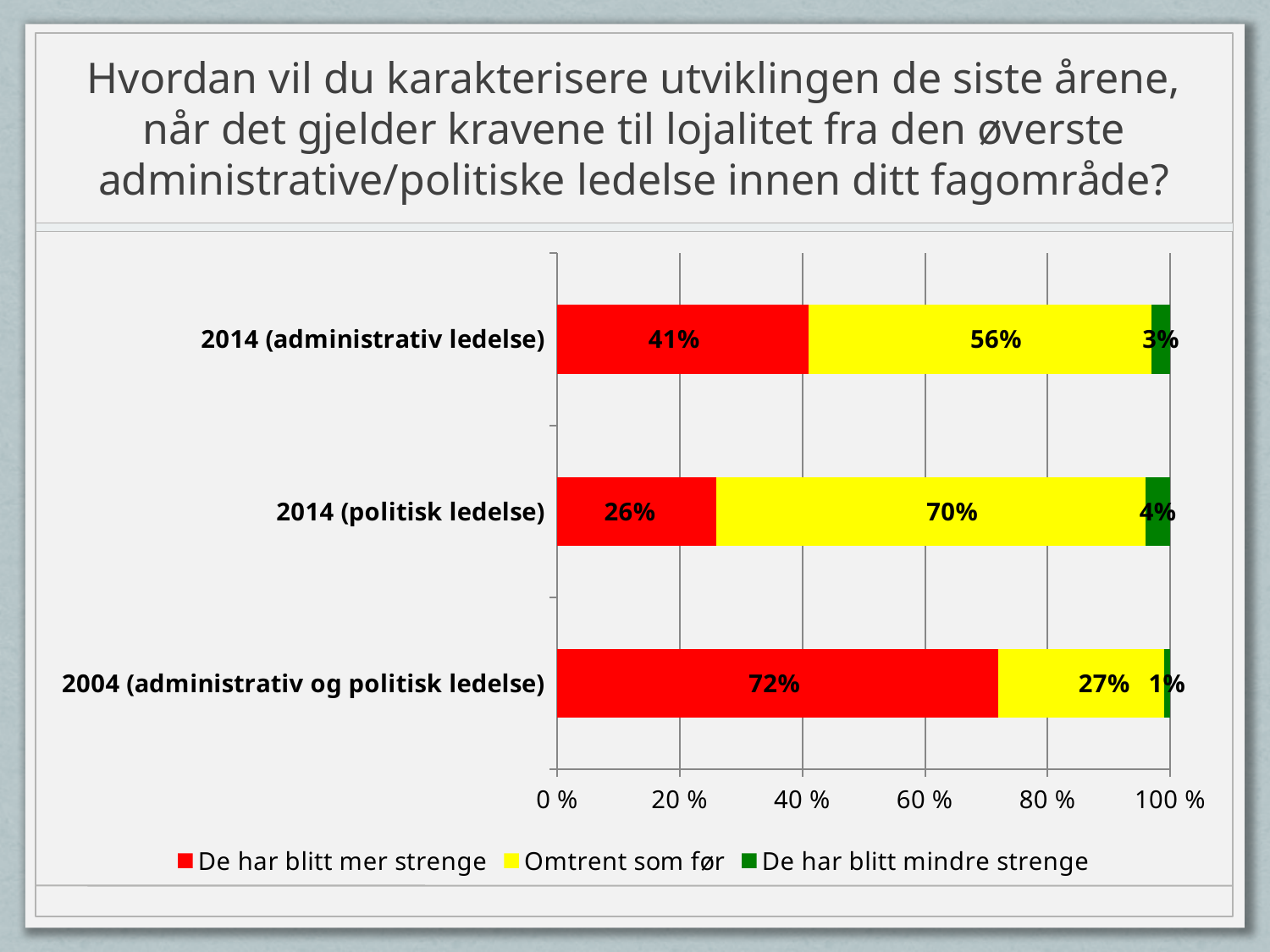
Which category has the lowest share for "Omtrent som før"? 2004 (administrativ og politisk ledelse) What percentage of respondents in the 2004 (administrativ og politisk ledelse) category answered "De har blitt mindre strenge"? 1% What percentage of respondents in the 2014 (administrativ ledelse) category answered "De har blitt mer strenge"? 41% Which is larger: the "De har blitt mindre strenge" share for 2014 (politisk ledelse) or for 2014 (administrativ ledelse)? 2014 (politisk ledelse) Which colour represents "Omtrent som før" in the chart? Yellow Which category has the highest share for "De har blitt mer strenge"? 2004 (administrativ og politisk ledelse) What percentage of respondents in the 2014 (politisk ledelse) category answered "Omtrent som før"? 70% How many series does the legend list? 3 What kind of chart is shown on the slide? Stacked bar chart What is the total of the three segments in the 2014 (administrativ ledelse) bar? 100% What is the difference between the "De har blitt mer strenge" share in 2004 (administrativ og politisk ledelse) and in 2014 (administrativ ledelse)? 31% How many categories are shown on the chart? 3